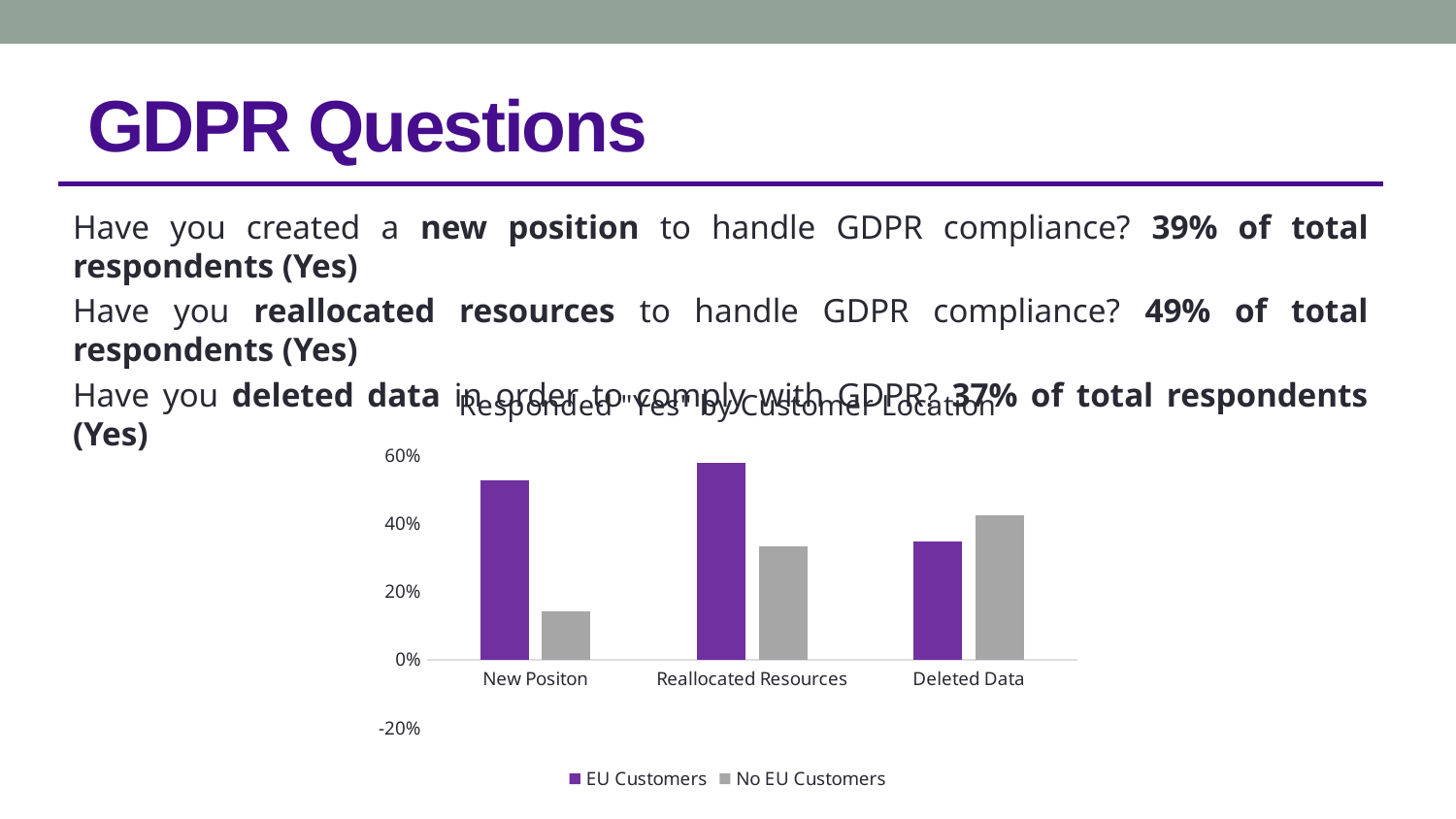
In the Deleted Data category, which series has the larger value, EU Customers or No EU Customers? No EU Customers How many series does the chart's legend list? 2 Is the value for No EU Customers in the New Positon category greater or less than 20%? less For which category is the No EU Customers bar the lowest? New Positon Is the value for No EU Customers in the Reallocated Resources category greater or less than 40%? less For which category is the EU Customers bar the highest? Reallocated Resources How many categories are shown on the x axis of the chart? 3 What are the two series listed in the chart's legend? EU Customers and No EU Customers Is the value for EU Customers in the New Positon category greater or less than 40%? greater Which series is shown in purple in the chart? EU Customers What kind of chart is shown on the slide? bar chart